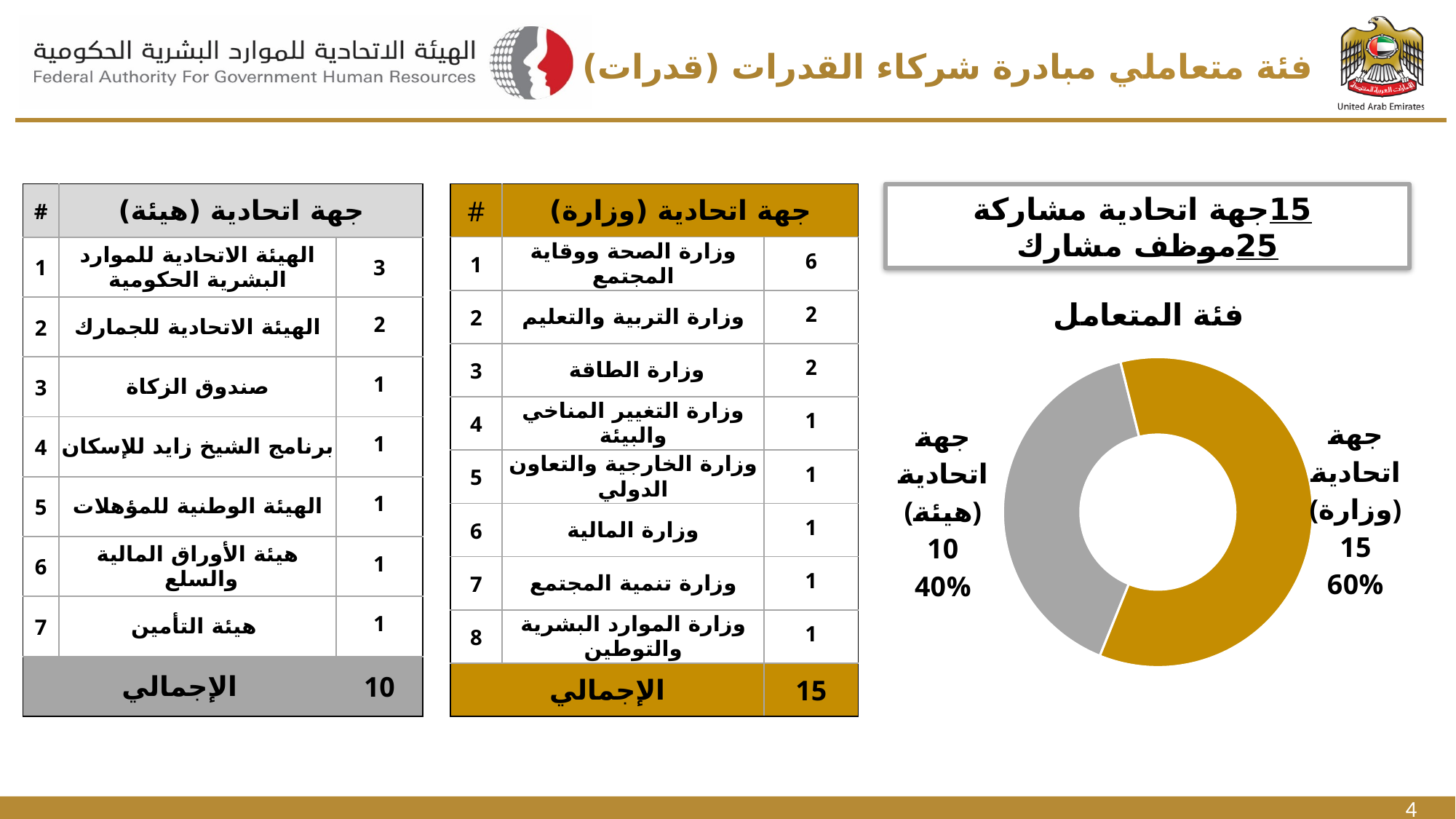
How many slices does the donut chart have? 2 In the donut chart, which is larger: "جهة اتحادية (وزارة)" or "جهة اتحادية (هيئة)"? جهة اتحادية (وزارة) Which category has the largest slice in the donut chart? جهة اتحادية (وزارة) What colour is the slice for "جهة اتحادية (هيئة)" in the donut chart? Grey Which category has the smallest slice in the donut chart? جهة اتحادية (هيئة) What is the total of the two values shown in the donut chart? 25 What is the value for "جهة اتحادية (هيئة)" in the donut chart? 10 What kind of chart is shown under the title "فئة المتعامل"? Donut (pie) chart What is the value for "جهة اتحادية (وزارة)" in the donut chart? 15 In the donut chart, what is the difference between the values for "جهة اتحادية (وزارة)" and "جهة اتحادية (هيئة)"? 5 What share of the donut chart does "جهة اتحادية (وزارة)" represent? 60% What share of the donut chart does "جهة اتحادية (هيئة)" represent? 40%